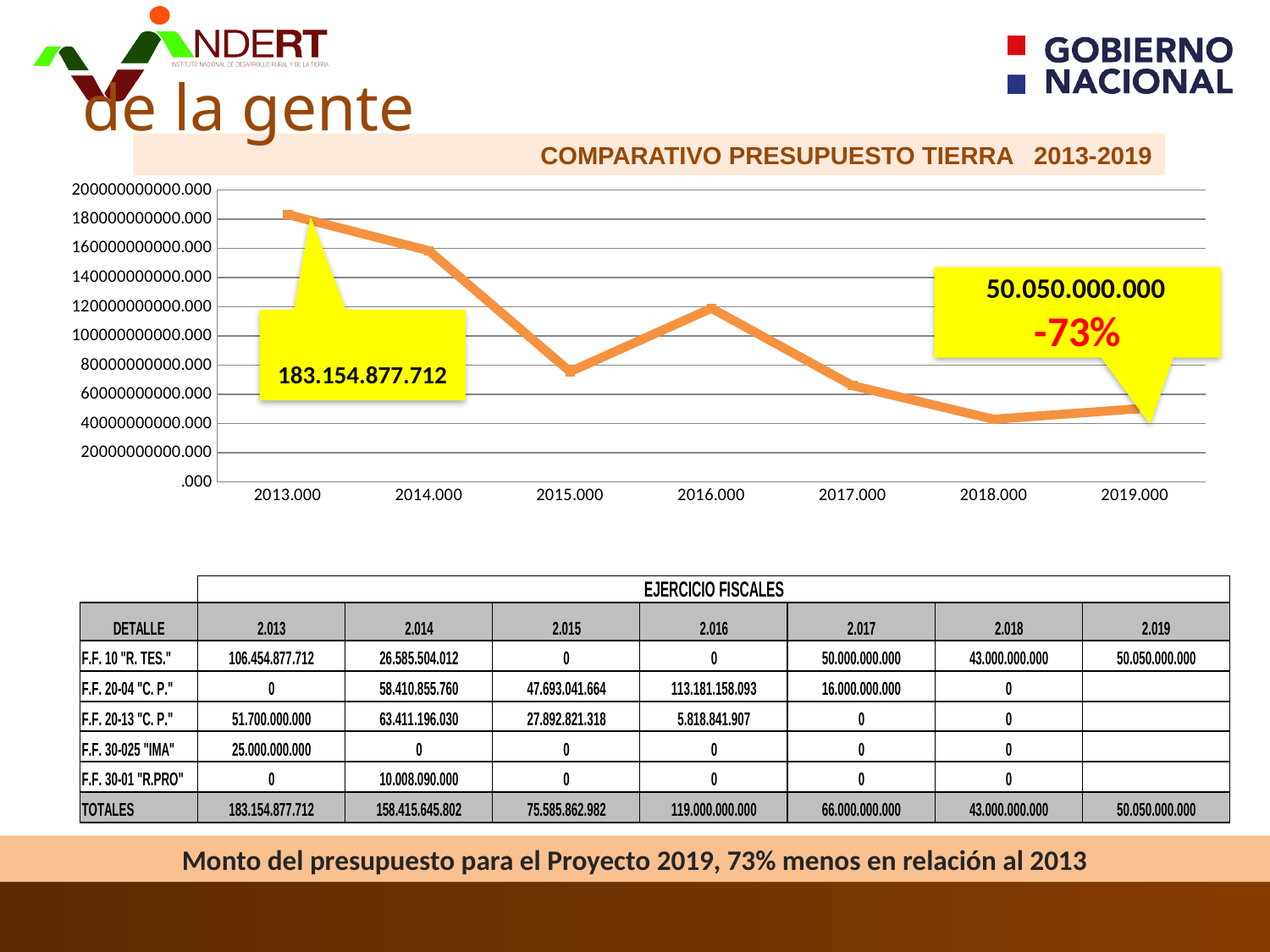
Do the values rise or fall from 2013.000 to 2015.000? fall Which year has the highest value on the line chart? 2013.000 Is the value for 2015.000 greater or less than 100000000000.000? less Is the value for 2016.000 greater or less than 100000000000.000? greater Which year has the larger value, 2014.000 or 2015.000? 2014.000 What kind of chart is shown on the slide? line chart How many data points are plotted on the line chart? 7 What is the difference between the 2013 value and the 2019 value shown on the chart? 133.104.877.712 What is the value shown for 2019 on the line chart? 50.050.000.000 What is the value shown for 2013 on the line chart? 183.154.877.712 What percentage change is shown in the callout next to the 2019 value? -73% Which year has the lowest value on the line chart? 2018.000